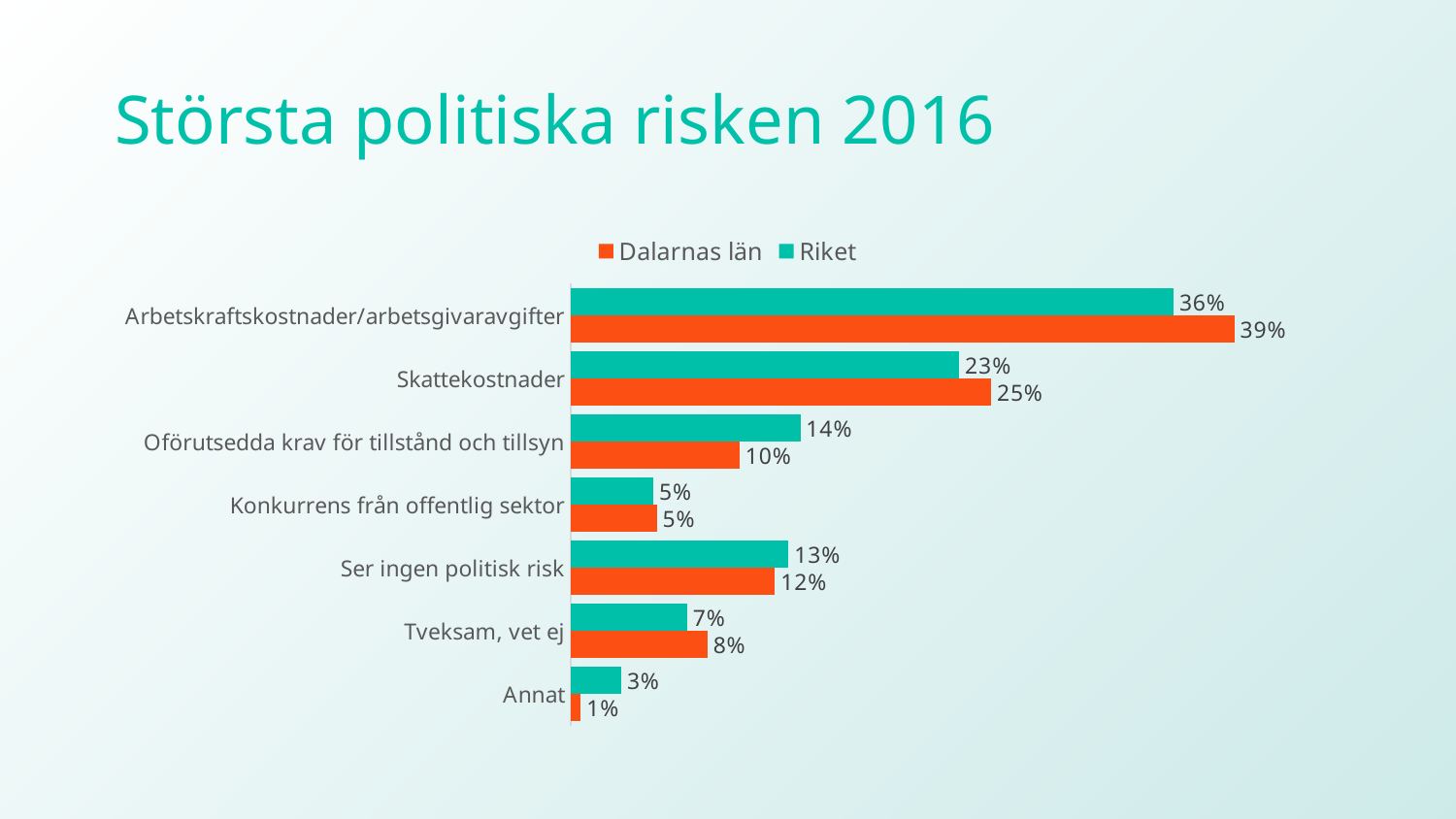
What is the difference between Riket and Dalarnas län for Oförutsedda krav för tillstånd och tillsyn? 4% Which category has the highest value for Riket? Arbetskraftskostnader/arbetsgivaravgifter Which category has the lowest value for Dalarnas län? Annat How many categories are shown in the chart? 7 How many series does the legend list? 2 What is the difference between Dalarnas län and Riket for Arbetskraftskostnader/arbetsgivaravgifter? 3% Which is larger for Ser ingen politisk risk, Dalarnas län or Riket? Riket What is the value for Dalarnas län for Oförutsedda krav för tillstånd och tillsyn? 10% What is the value for Riket for Annat? 3% What is the value for Dalarnas län for Arbetskraftskostnader/arbetsgivaravgifter? 39% What is the value for Riket for Skattekostnader? 23% What kind of chart is shown on the slide? Bar chart